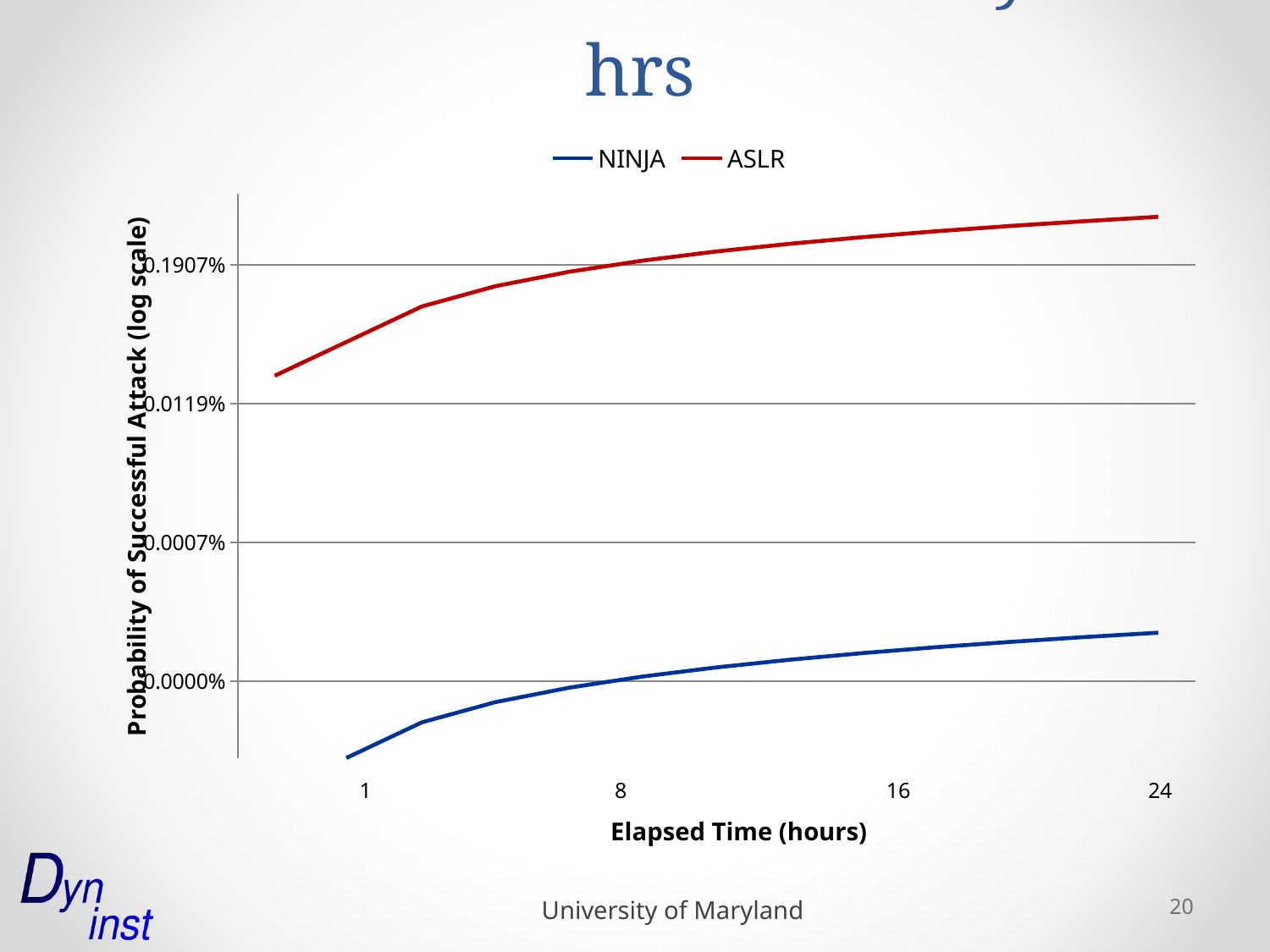
Which series has the higher probability of successful attack at 24 hours, NINJA or ASLR? ASLR Is the value for ASLR at 24 hours greater or less than 0.1907%? greater Does the ASLR line rise or fall as elapsed time increases? rise Is the value for NINJA at 8 hours greater or less than 0.0119%? less Is the value for NINJA at 24 hours greater or less than 0.0007%? less How many series does the legend list? 2 Which series has the lower probability of successful attack at 1 hour, NINJA or ASLR? NINJA Does the NINJA line rise or fall as elapsed time increases? rise Which series does the legend list first? NINJA What colour is the ASLR line? red What kind of chart is shown on the slide? line chart